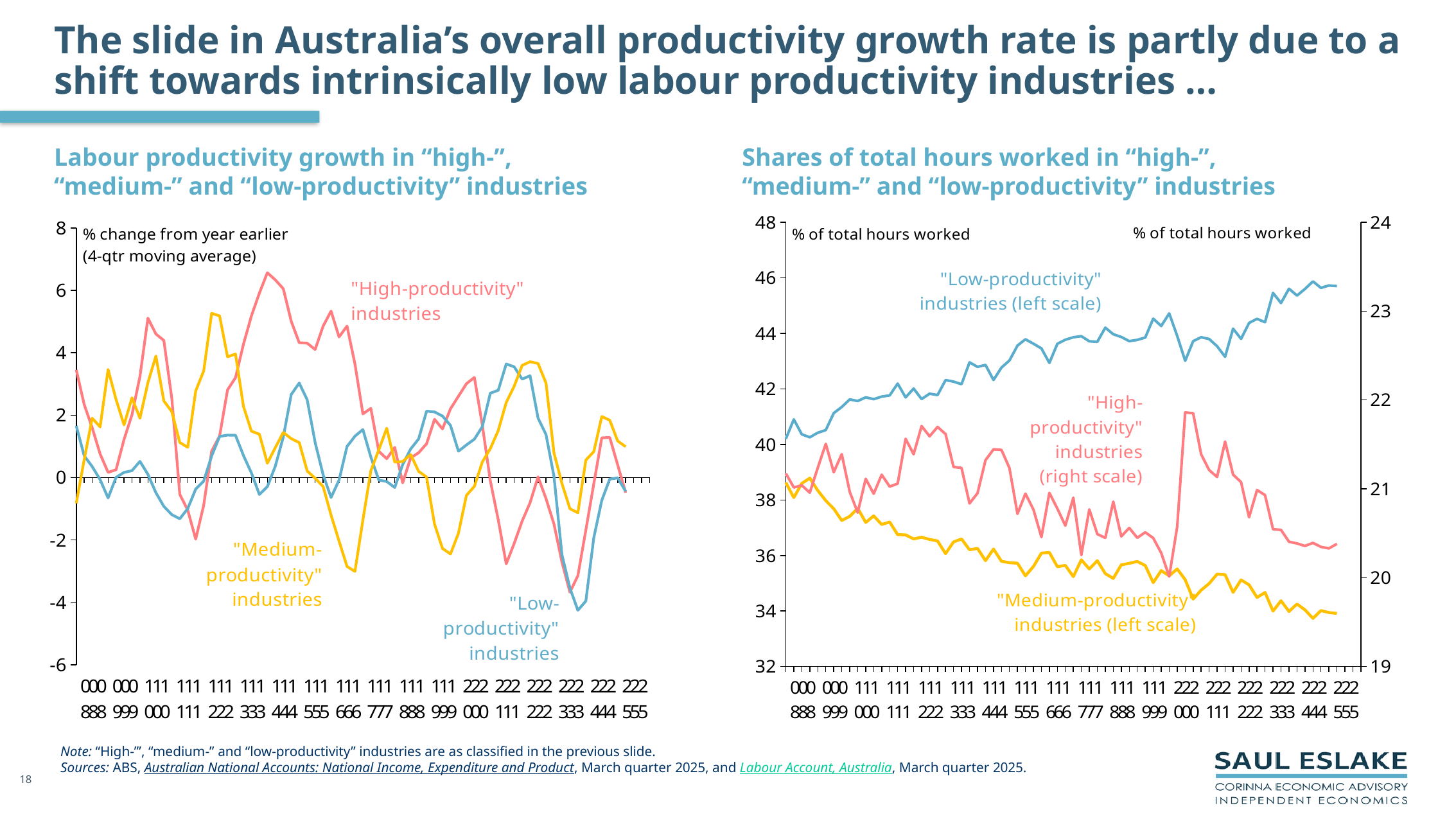
On the right chart, 'Shares of total hours worked', is the final value for "Medium-productivity" industries (left scale) greater or less than 36? less On the right chart, 'Shares of total hours worked', does the share for "Medium-productivity" industries rise or fall over the period shown? fall How many series are plotted on the right chart, 'Shares of total hours worked'? 3 On the right chart, 'Shares of total hours worked', is the final value for "Low-productivity" industries (left scale) greater or less than 44? greater On the right chart, 'Shares of total hours worked', does the share for "Low-productivity" industries rise or fall over the period shown? rise What type of chart is the left chart, 'Labour productivity growth in high-, medium- and low-productivity industries'? line chart How many series are plotted on the left chart, 'Labour productivity growth'? 3 On the right chart, 'Shares of total hours worked', at the end of the period, which is larger on the left scale: the "Low-productivity" share or the "Medium-productivity" share? "Low-productivity" industries What unit label is shown on the vertical axis of the right chart, 'Shares of total hours worked'? % of total hours worked What type of chart is the right chart, 'Shares of total hours worked in high-, medium- and low-productivity industries'? line chart On the right chart, 'Shares of total hours worked', which series is plotted against the right scale? "High-productivity" industries On the left chart, 'Labour productivity growth', is the peak value for "High-productivity" industries greater or less than 6? greater